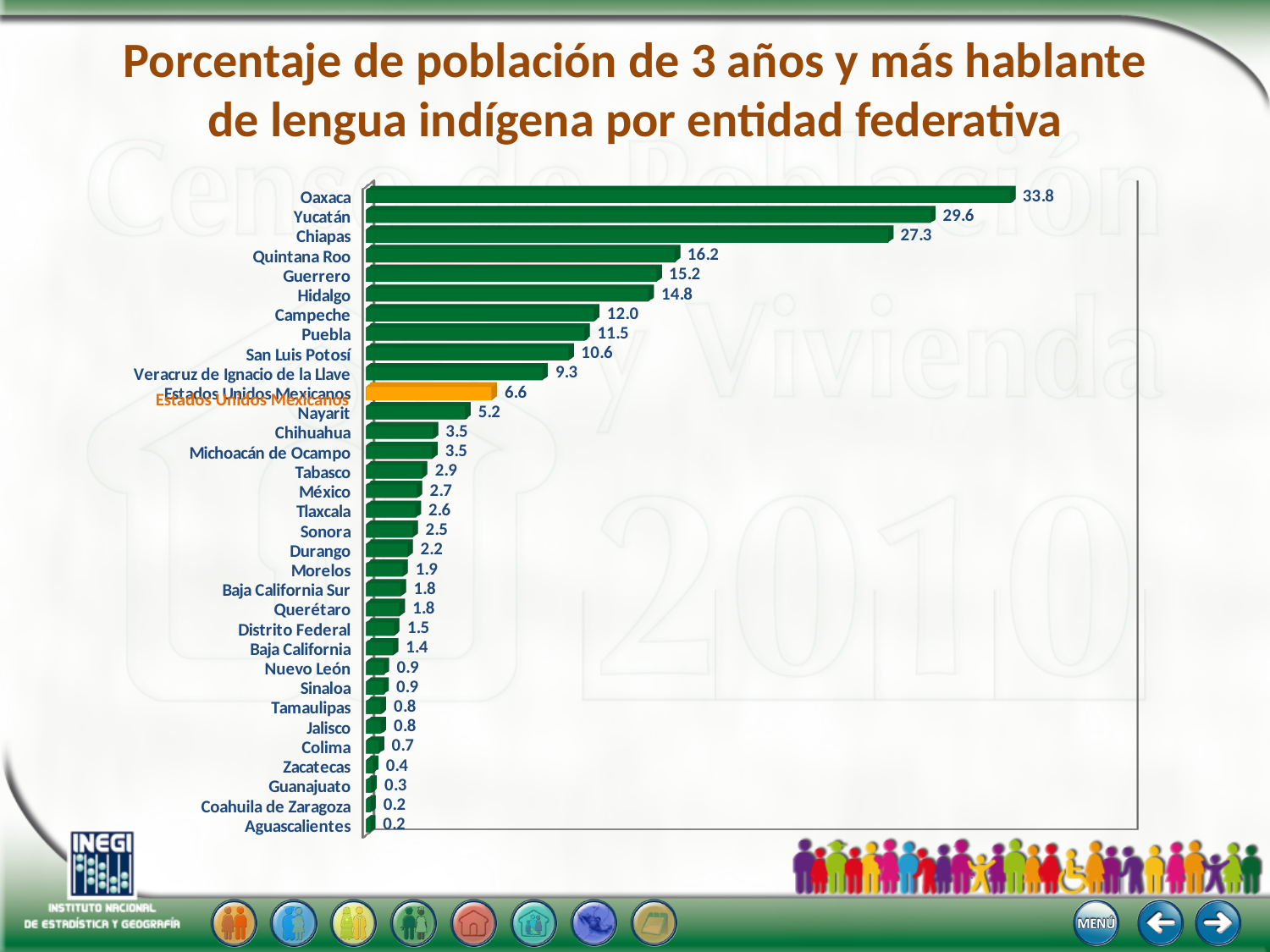
What is the difference between the values for Quintana Roo and Guerrero? 1.0 Which bar is shown in a different colour (orange) from the others? Estados Unidos Mexicanos Which has a larger value, Nayarit or Tabasco? Nayarit What is the difference between the values for Oaxaca and Yucatán? 4.2 What is the value for Campeche? 12.0 Which has a larger value, Hidalgo or Puebla? Hidalgo What is the value for Estados Unidos Mexicanos? 6.6 What is the value for Chiapas? 27.3 What is the value for Nuevo León? 0.9 What type of chart is shown on the slide? bar chart What is the value for Oaxaca? 33.8 Which entity has the highest value? Oaxaca